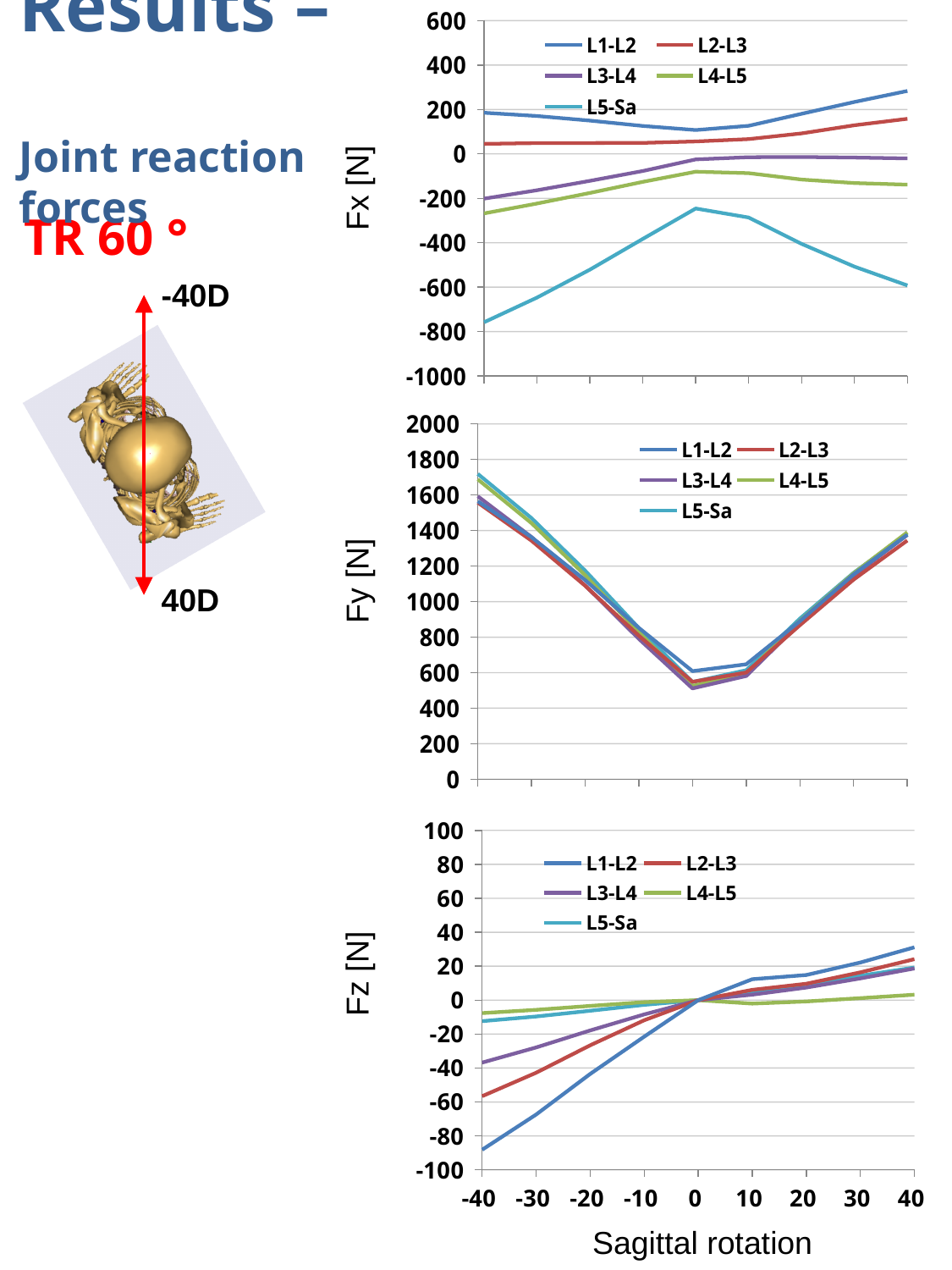
In the Fy [N] chart, is the value of L3-L4 at a sagittal rotation of 0 greater or less than 600? less In the Fz [N] chart, which series has the lowest value at a sagittal rotation of -40? L1-L2 How many series does the legend of the Fx [N] chart list? 5 In the Fz [N] chart, which is larger at a sagittal rotation of 40: L1-L2 or L4-L5? L1-L2 In the Fx [N] chart, which series has the lowest value at a sagittal rotation of -40? L5-Sa In the Fy [N] chart, is the value of L5-Sa at a sagittal rotation of -40 greater or less than 1600? greater In the Fz [N] chart, does the L1-L2 series rise or fall as sagittal rotation increases from -40 to 40? rise In the Fy [N] chart, does the L1-L2 series rise or fall as sagittal rotation goes from -40 to 0? fall In the Fx [N] chart, which series has the highest value at a sagittal rotation of 40? L1-L2 What kind of chart is the Fx [N] chart? line chart What is the x-axis title shown below the Fz [N] chart? Sagittal rotation In the Fx [N] chart, is the value of L5-Sa at a sagittal rotation of -40 greater or less than -600? less